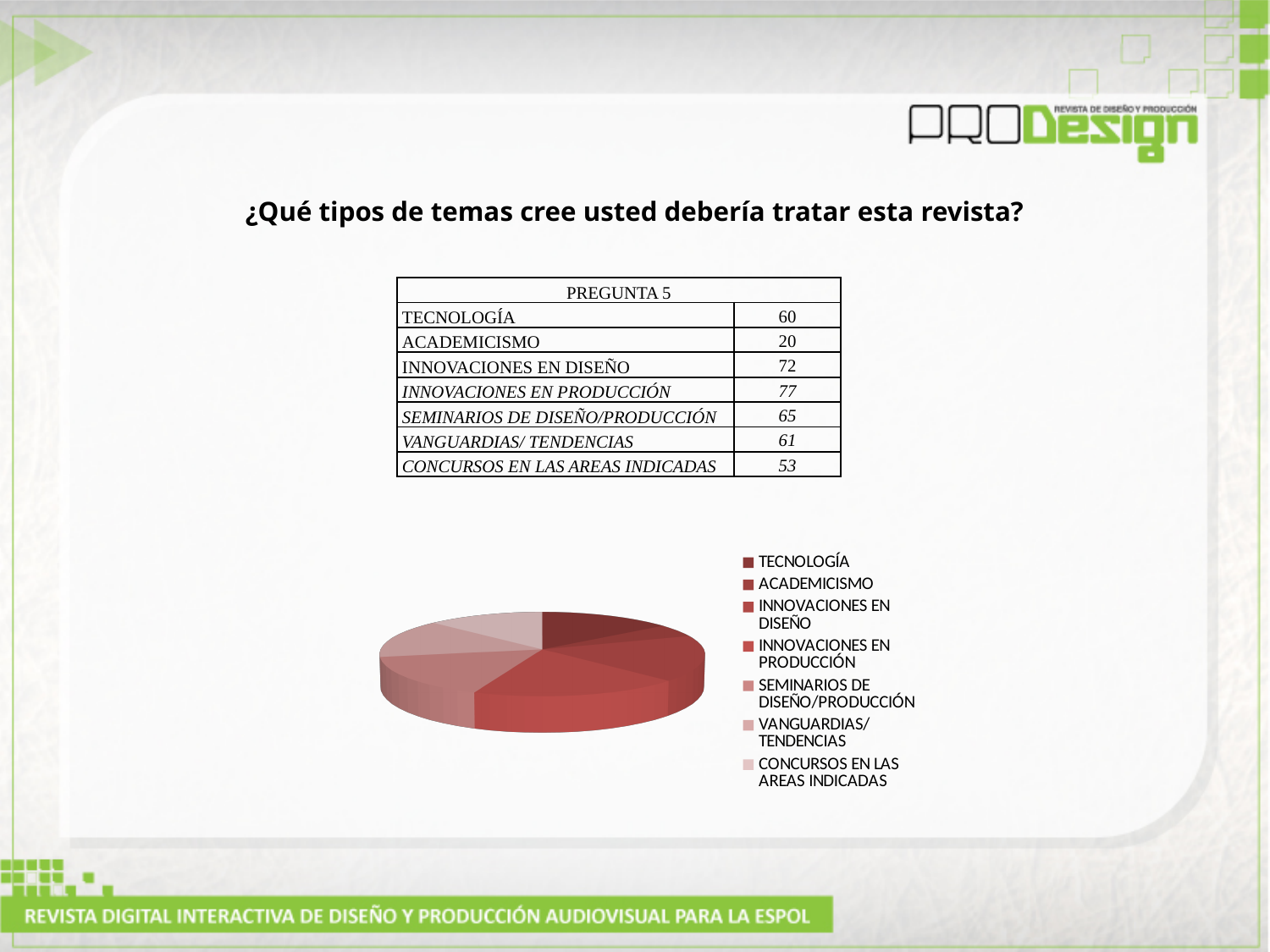
How many slices does the pie chart have? 7 What is the value for INNOVACIONES EN PRODUCCIÓN? 77 What is the value for CONCURSOS EN LAS AREAS INDICADAS? 53 What is the value for ACADEMICISMO? 20 What is the value for TECNOLOGÍA? 60 Which category has the highest value? INNOVACIONES EN PRODUCCIÓN What kind of chart is shown on the slide? pie chart What is the difference between the values for INNOVACIONES EN PRODUCCIÓN and ACADEMICISMO? 57 What is the title of the table above the pie chart? PREGUNTA 5 How many entries does the legend of the pie chart list? 7 Which category has the lowest value? ACADEMICISMO Which is larger, the value for INNOVACIONES EN DISEÑO or the value for CONCURSOS EN LAS AREAS INDICADAS? INNOVACIONES EN DISEÑO